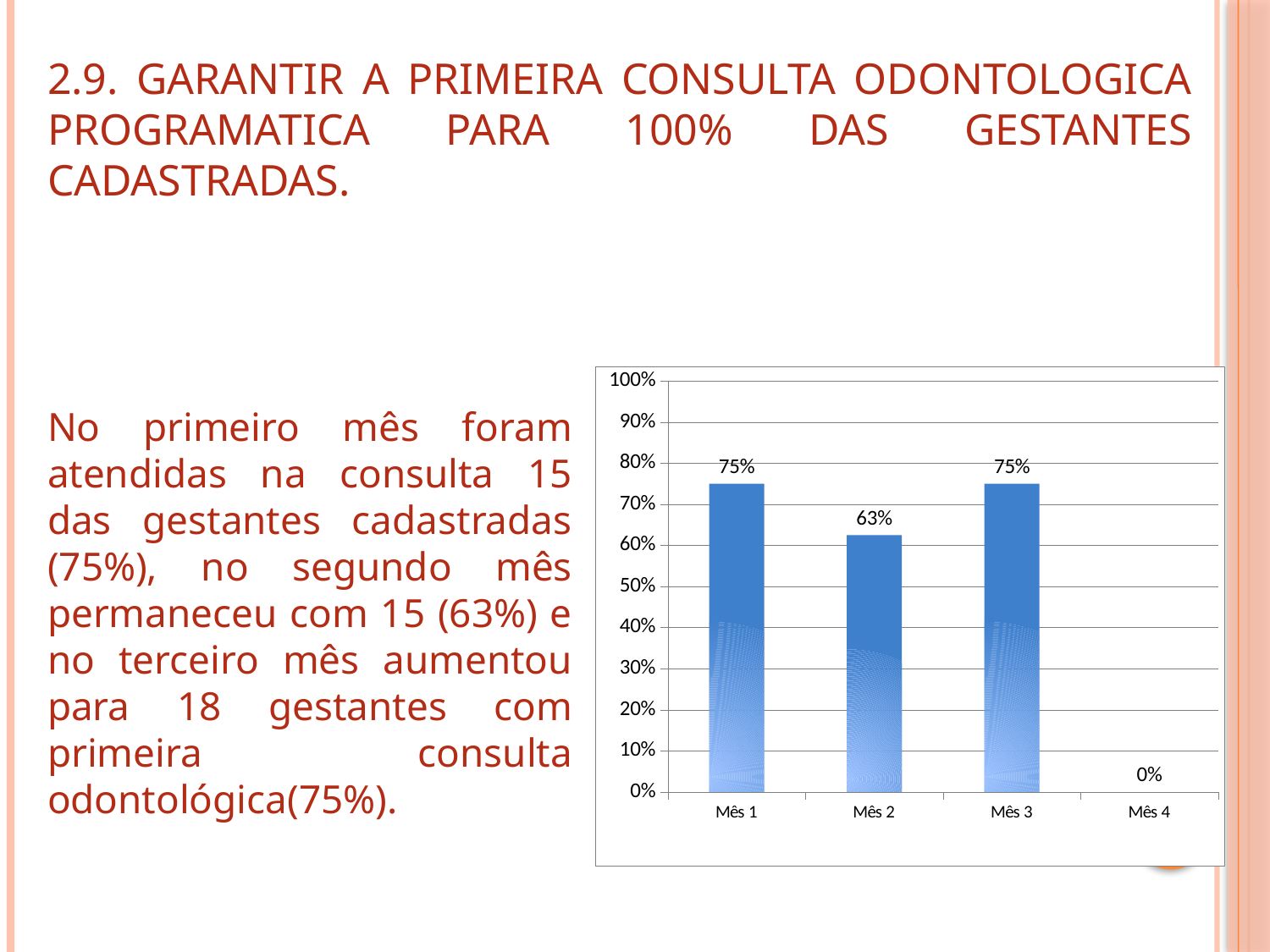
What is the value for Mês 4? 0% Is the value for Mês 2 greater or less than 70%? less What is the difference between the values for Mês 1 and Mês 2? 12% What is the value for Mês 1? 75% How many categories are shown on the x axis? 4 What colour are the bars in the chart? blue Which category has the lowest value? Mês 4 What is the highest value shown on the y axis? 100% What is the value for Mês 2? 63% What is the value for Mês 3? 75% What kind of chart is shown on the slide? bar chart Which is larger, the value for Mês 2 or the value for Mês 3? Mês 3